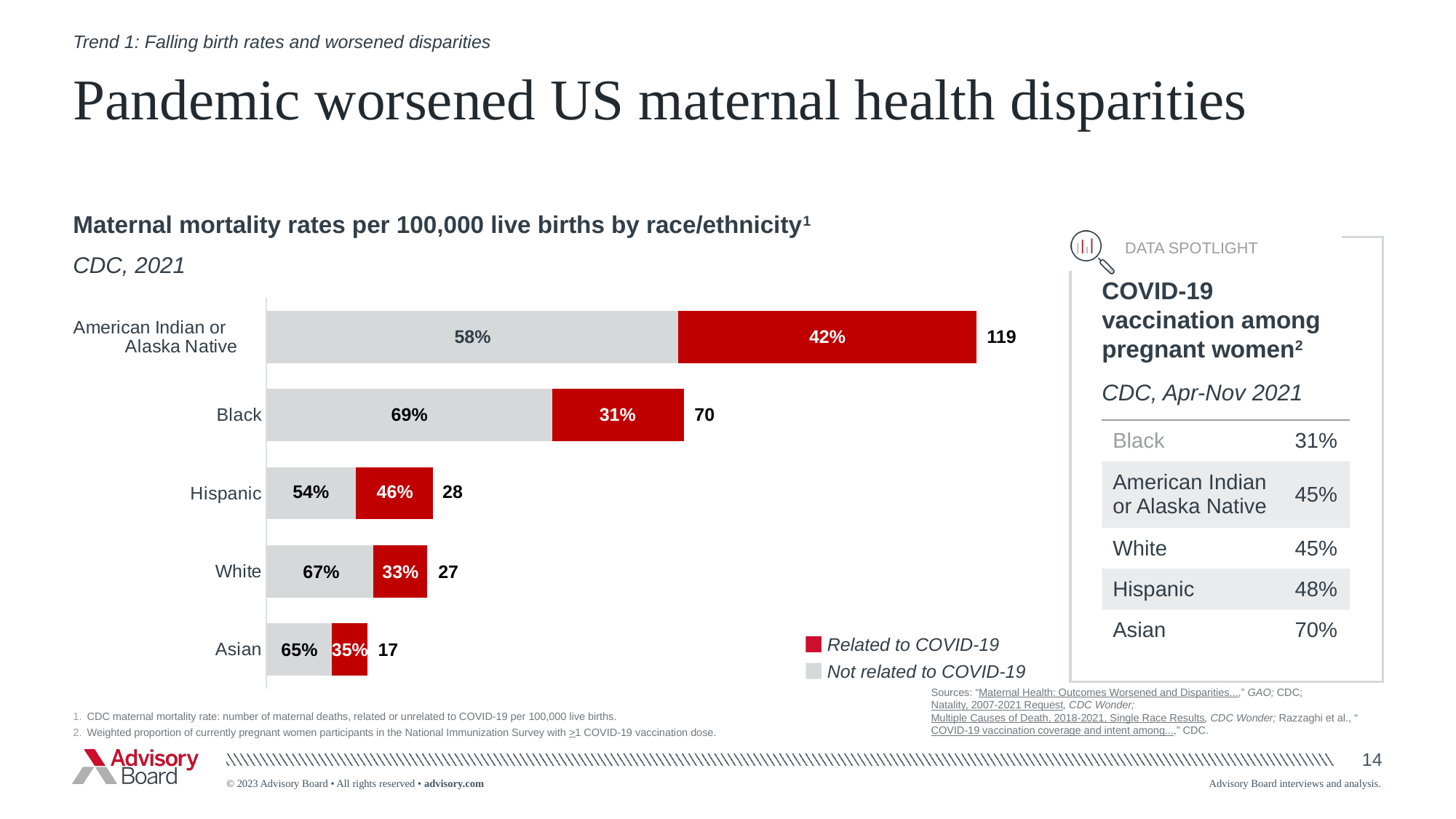
What percentage of maternal deaths among Asian women is labelled as not related to COVID-19? 65% What kind of chart is used to show maternal mortality rates by race/ethnicity? Stacked bar chart Which colour represents deaths related to COVID-19 in the chart? Red How many race/ethnicity categories are shown in the chart? 5 Which race/ethnicity has the highest maternal mortality rate in the chart? American Indian or Alaska Native What is the difference between the maternal mortality rates for American Indian or Alaska Native women and Black women? 49 What percentage of maternal deaths among American Indian or Alaska Native women is labelled as not related to COVID-19? 58% What is the maternal mortality rate per 100,000 live births for Black women in the chart? 70 How many series does the chart's legend list? 2 Which race/ethnicity has the lowest maternal mortality rate in the chart? Asian What percentage of maternal deaths among Hispanic women is labelled as related to COVID-19? 46% Which has the higher maternal mortality rate, Hispanic or White women? Hispanic